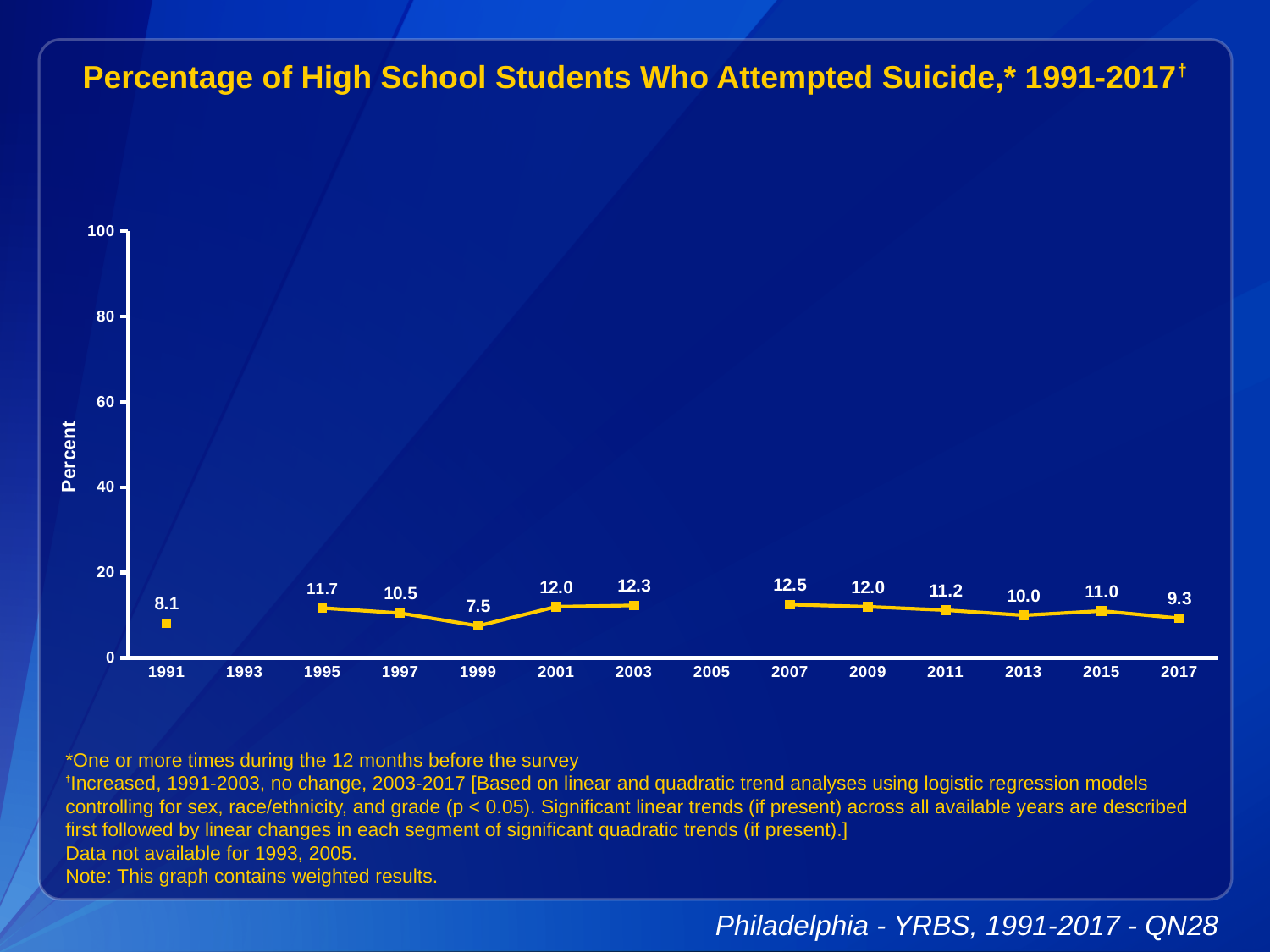
How many data points are plotted on the chart? 12 What is the value plotted for 2003? 12.3 Which year has the highest plotted value? 2007 Which year has the lowest plotted value? 1999 What is the difference between the values for 2007 and 1991? 4.4 What percentage of high school students attempted suicide in 1991? 8.1 What is the label on the y axis? Percent Which is larger, the value for 1995 or the value for 1997? 1995 What kind of chart is shown on the slide? line chart Is the value for 2009 greater or less than 20? less What is the value plotted for 2017? 9.3 Do the values rise or fall from 2007 to 2017? fall